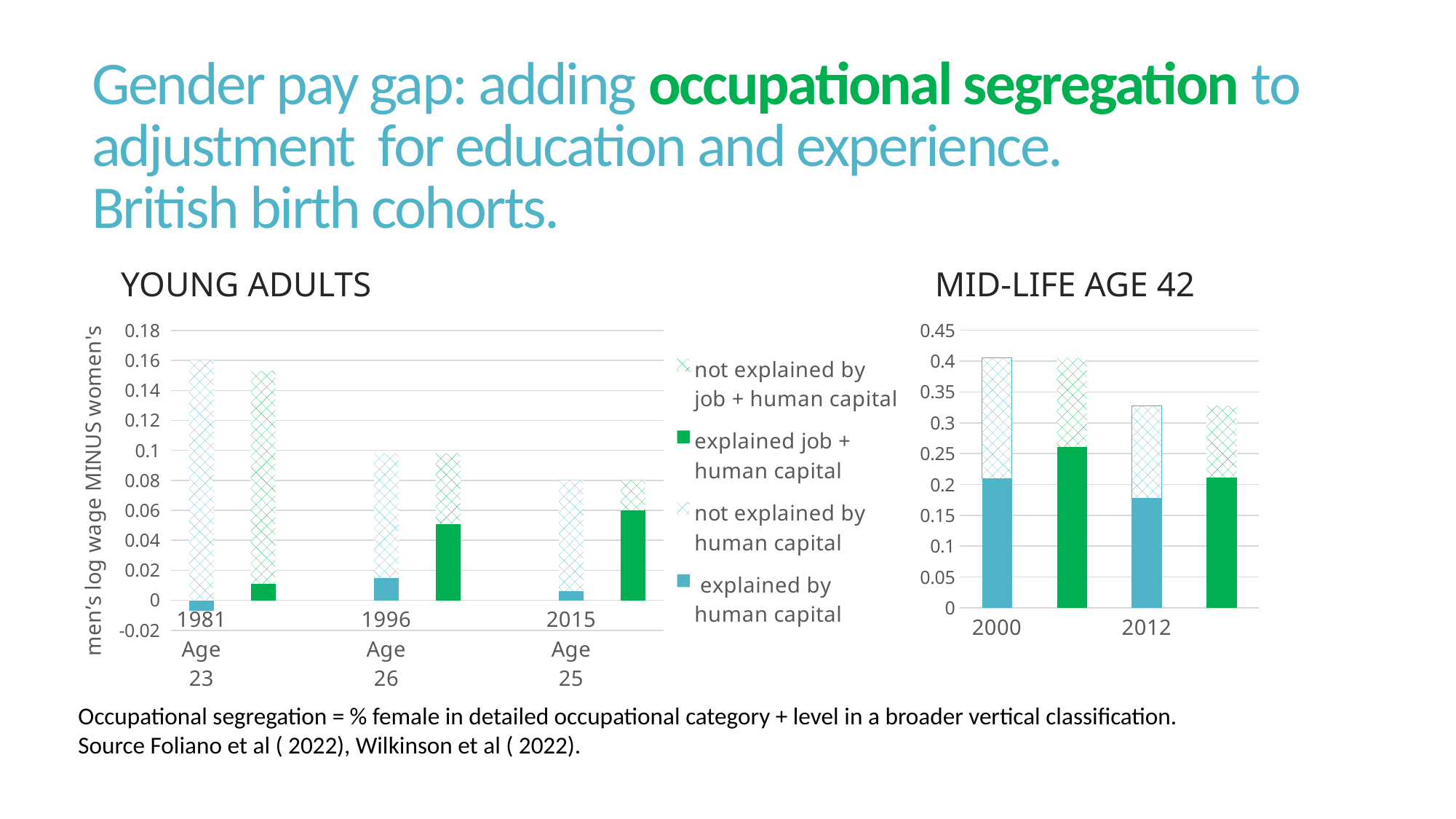
What kind of chart is the YOUNG ADULTS chart? bar chart How many year categories are shown on the x axis of the MID-LIFE AGE 42 chart? 2 What is the y-axis label of the YOUNG ADULTS chart? men's log wage MINUS women's How many series does the legend list? 4 In the MID-LIFE AGE 42 chart, is the total height of the first (human capital) stacked bar for 2000 greater or less than 0.35? greater In the MID-LIFE AGE 42 chart, is the 'explained by human capital' value for 2000 greater or less than 0.15? greater In the YOUNG ADULTS chart, does the total gender pay gap rise or fall from 1981 to 2015? fall How many year categories are shown on the x axis of the YOUNG ADULTS chart? 3 In the YOUNG ADULTS chart, is the total height of the first (human capital) stacked bar for 1981 greater or less than 0.14? greater In the YOUNG ADULTS chart, which is larger: the 'explained job + human capital' value for 1981 or for 2015? 2015 In the YOUNG ADULTS chart, which year has the tallest stacked bars? 1981